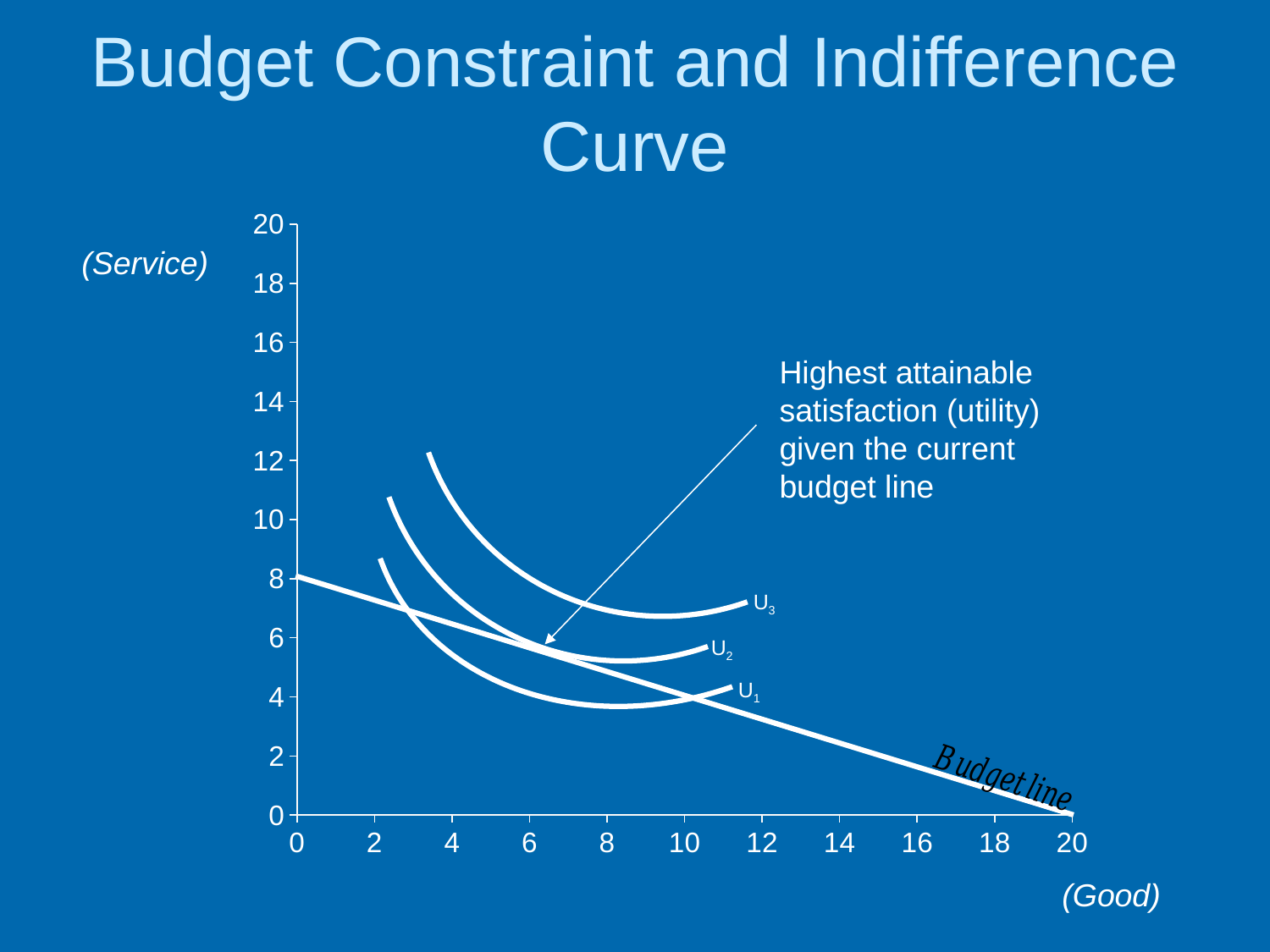
What are the labels of the three indifference curves? U1, U2, U3 Is the value of the budget line at Good = 10 greater or less than 6 on the Service axis? less Which indifference curve is tangent to the budget line at the point marked as the highest attainable satisfaction? U2 Which indifference curve lies lowest on the chart? U1 Which indifference curve lies highest on the chart? U3 What kind of chart is shown on the slide? line chart Does the budget line rise or fall as Good increases along the x axis? fall At what value on the Good axis does the budget line reach zero Service? 20 At what value on the Service axis does the budget line start? 8 How many indifference curves are drawn on the chart? 3 Which of the two curves, U1 or U3, is higher on the chart? U3 What is the highest value shown on the Service (vertical) axis? 20